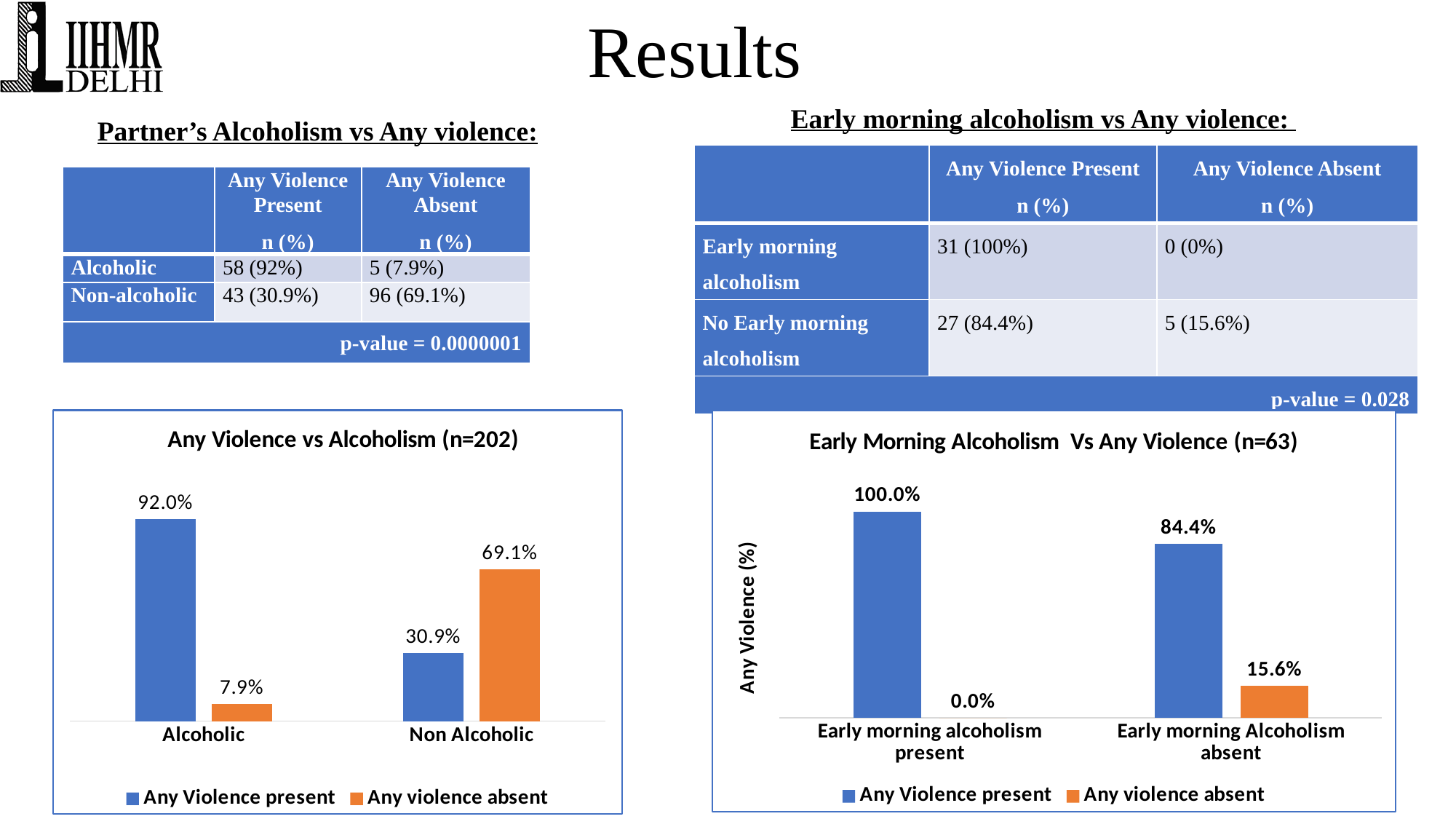
In the 'Early Morning Alcoholism Vs Any Violence (n=63)' chart, which bar has the lowest value? Any violence absent, Early morning alcoholism present (0.0%) What is the y-axis label of the 'Early Morning Alcoholism Vs Any Violence (n=63)' chart? Any Violence (%) In the 'Early Morning Alcoholism Vs Any Violence (n=63)' chart, what is the value for 'Any Violence present' when early morning alcoholism is present? 100.0% In the 'Any Violence vs Alcoholism (n=202)' chart, how many series does the legend list? 2 In the 'Any Violence vs Alcoholism (n=202)' chart, what is the value for 'Any Violence present' in the Alcoholic category? 92.0% In the 'Early Morning Alcoholism Vs Any Violence (n=63)' chart, what is the value for 'Any violence absent' when early morning alcoholism is absent? 15.6% In the 'Early Morning Alcoholism Vs Any Violence (n=63)' chart, how many categories are shown on the x axis? 2 In the 'Any Violence vs Alcoholism (n=202)' chart, what is the value for 'Any violence absent' in the Non Alcoholic category? 69.1% In the 'Any Violence vs Alcoholism (n=202)' chart, which category has the higher 'Any Violence present' value, Alcoholic or Non Alcoholic? Alcoholic In the 'Early Morning Alcoholism Vs Any Violence (n=63)' chart, what is the difference between 'Any Violence present' and 'Any violence absent' when early morning alcoholism is absent? 68.8% In the 'Any Violence vs Alcoholism (n=202)' chart, what is the difference between 'Any Violence present' and 'Any violence absent' for the Alcoholic category? 84.1% What kind of chart is 'Any Violence vs Alcoholism (n=202)'? Bar chart